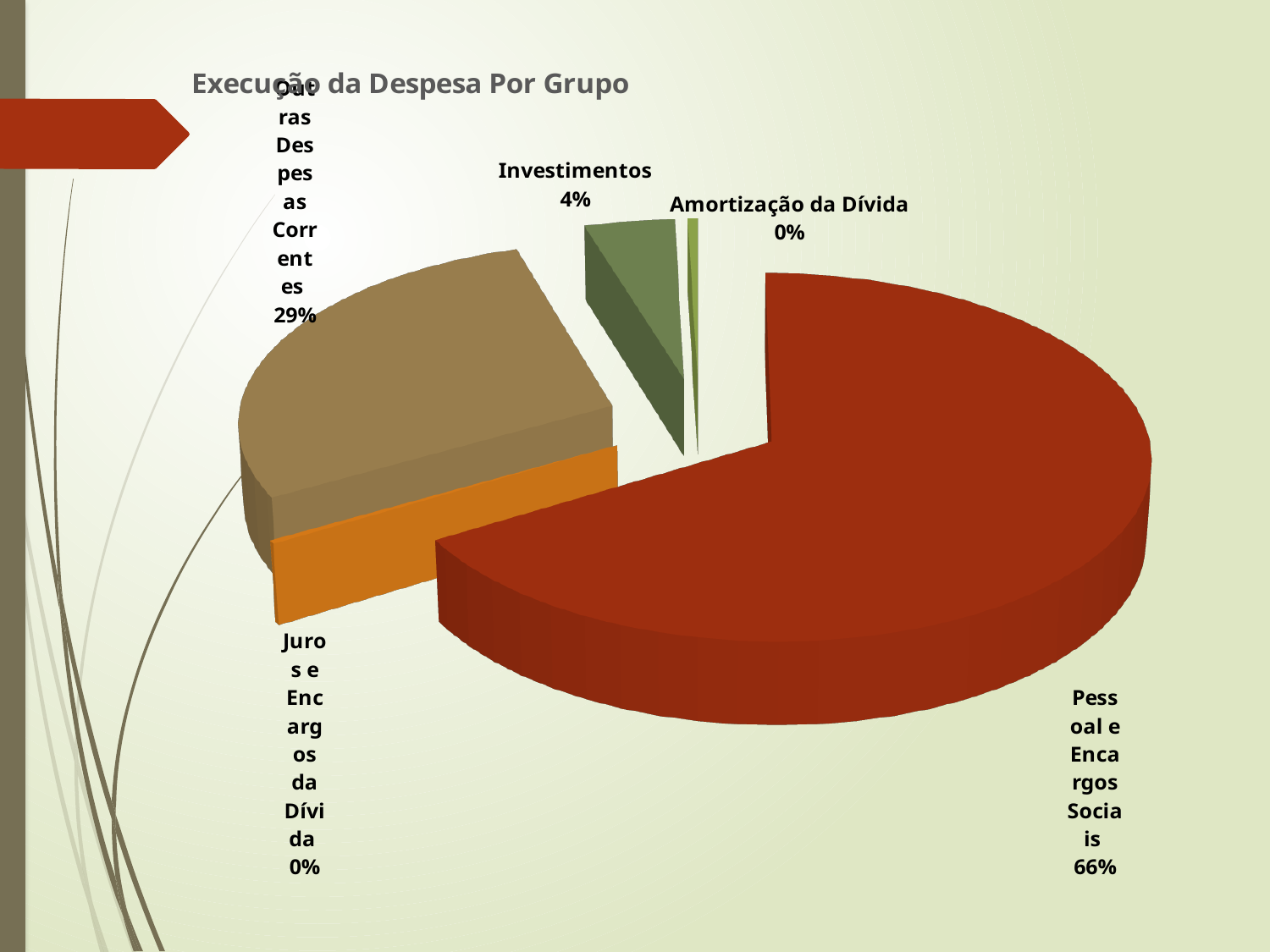
What share of the pie does Juros e Encargos da Dívida represent? 0% What kind of chart is shown on the slide? pie chart What share of the pie does Outras Despesas Correntes represent? 29% How many categories are shown in the pie chart? 5 What is the difference in percentage points between Pessoal e Encargos Sociais and Outras Despesas Correntes? 37 What colour is the slice for Pessoal e Encargos Sociais? red What share of the pie does Investimentos represent? 4% Which category has the largest slice of the pie? Pessoal e Encargos Sociais What is the title of the chart? Execução da Despesa Por Grupo Which is larger, Outras Despesas Correntes or Investimentos? Outras Despesas Correntes